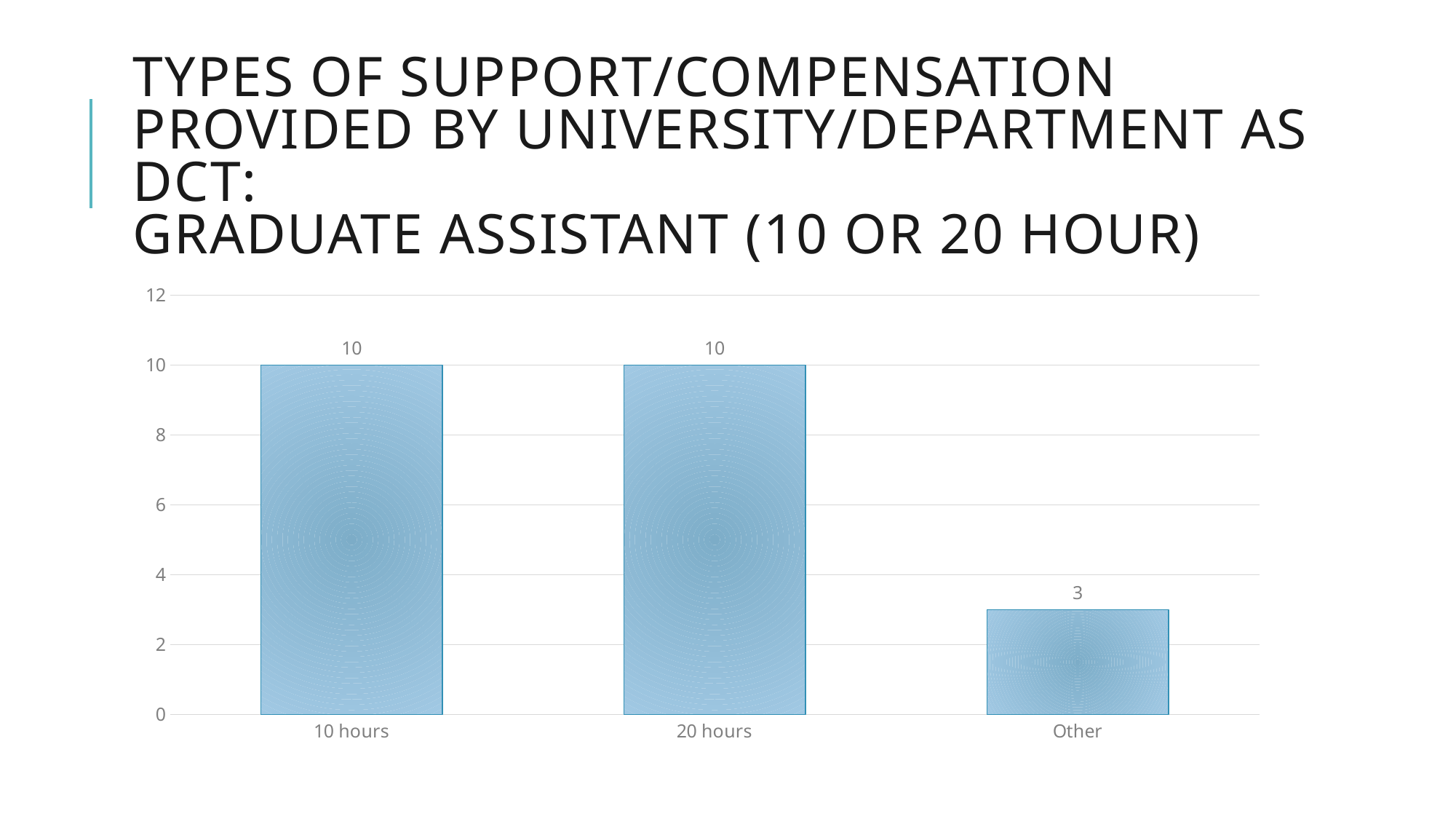
Is the value for Other greater or less than 4? less Which is larger, the value for 20 hours or the value for Other? 20 hours What is the value for 20 hours? 10 What is the value for 10 hours? 10 Which category has the lowest value? Other Is the value for 10 hours greater or less than 8? greater What is the difference between the values for 10 hours and Other? 7 What kind of chart is shown on the slide? bar chart What is the maximum value shown on the y axis? 12 What is the total of the values for 10 hours, 20 hours and Other? 23 How many categories are shown on the x axis? 3 What is the value for Other? 3